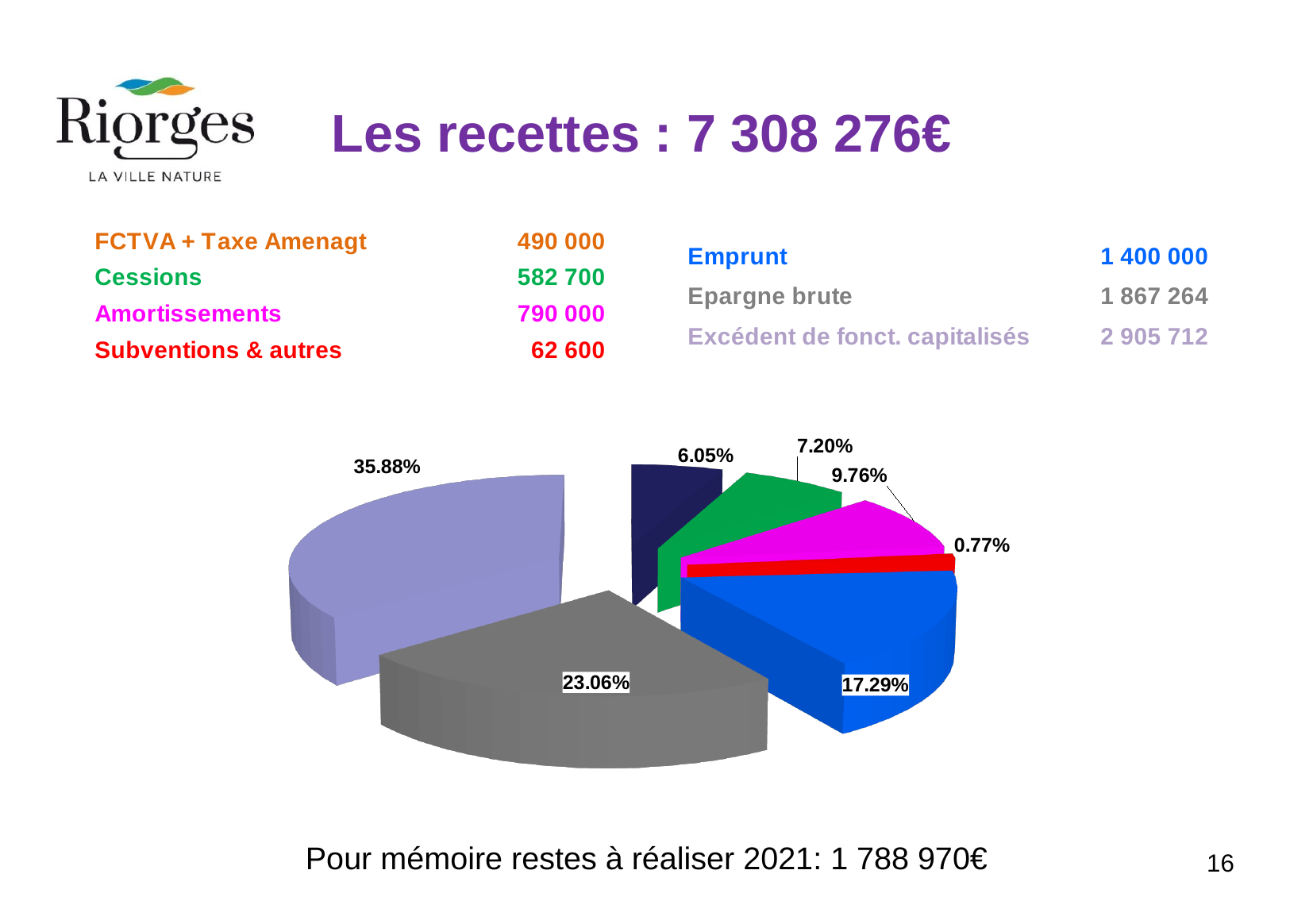
How many slices does the pie chart have? 7 What percentage is labelled on the dark navy slice of the pie chart? 6.05% What percentage is labelled on the magenta slice of the pie chart? 9.76% What is the percentage shown for the smallest slice of the pie chart? 0.77% What percentage is labelled on the green slice of the pie chart? 7.20% What kind of chart is shown on the slide? Pie chart What is the title of the slide containing the pie chart? Les recettes : 7 308 276€ What is the percentage shown for the largest slice of the pie chart? 35.88% What percentage is labelled on the grey slice of the pie chart? 23.06% By how many percentage points does the largest slice (35.88%) exceed the grey slice (23.06%)? 12.82 percentage points What percentage is labelled on the blue slice of the pie chart? 17.29% Which slice is larger, the blue slice or the grey slice? The grey slice